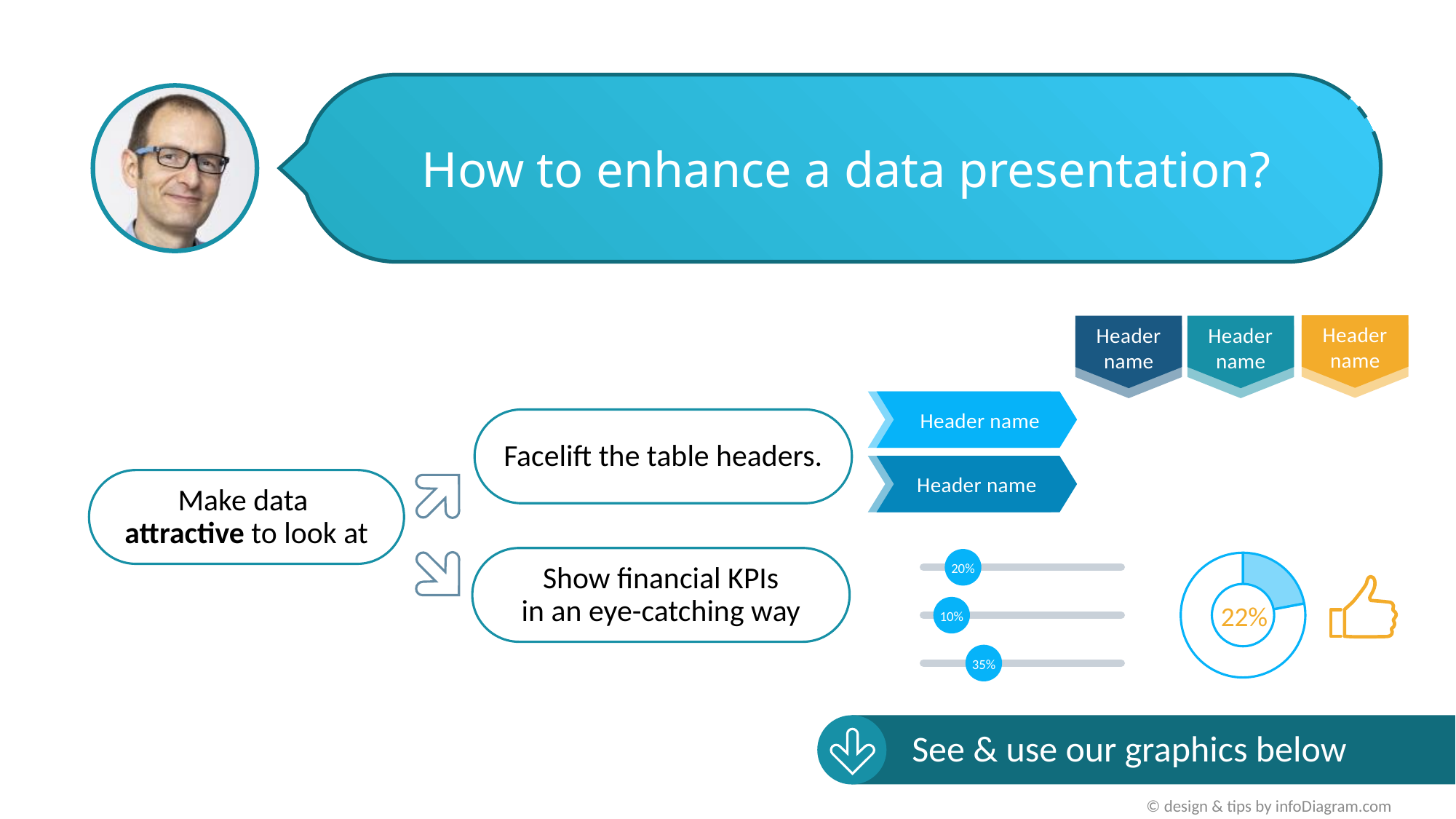
Which of the three slider indicators shows the lowest value? The middle one (10%) What value is shown on the top slider indicator? 20% What value is shown on the middle slider indicator? 10% What kind of chart is the circular graphic next to the thumbs-up icon? Donut (pie) chart What value is shown on the bottom slider indicator? 35% Which of the three slider indicators shows the highest value? The bottom one (35%) How many 'Header name' table header shapes are shown on the slide? 5 What percentage is shown in the centre of the donut chart on the right of the slide? 22% What colour is the third (rightmost) 'Header name' shape in the top row? Orange/yellow How many slider KPI indicators are shown to the right of the 'Show financial KPIs' box? 3 Is the value on the top slider larger or smaller than the value on the middle slider? Larger What is the difference between the highest and lowest slider values? 25%